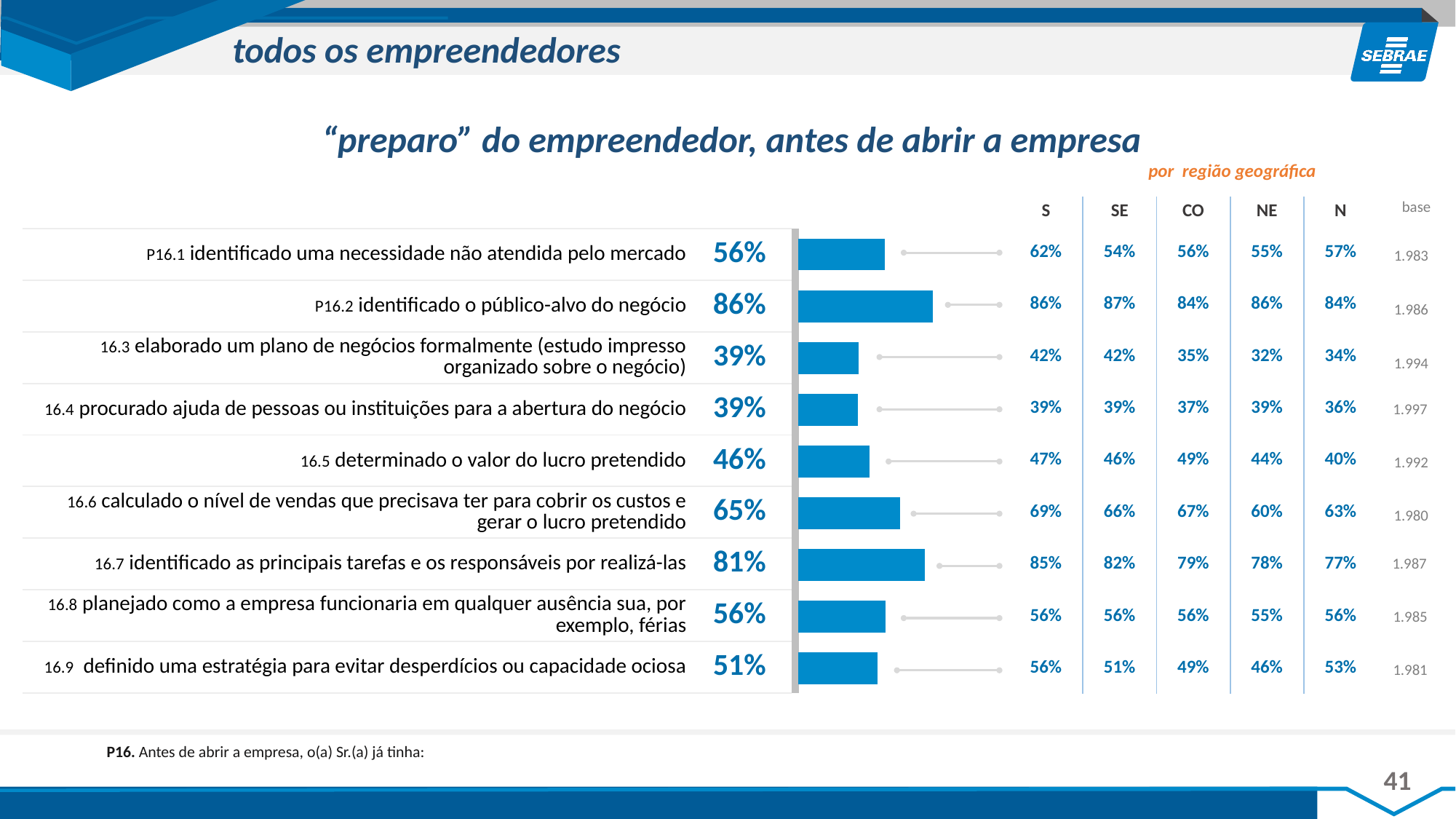
What type of chart is shown on the slide? bar chart What is the value for '16.9 definido uma estratégia para evitar desperdícios ou capacidade ociosa'? 51% Which item has the highest value in the chart? P16.2 identificado o público-alvo do negócio Which is larger: the value for '16.5 determinado o valor do lucro pretendido' or for '16.9 definido uma estratégia para evitar desperdícios ou capacidade ociosa'? 16.9 definido uma estratégia para evitar desperdícios ou capacidade ociosa In the regional table, what is the value for region S for 'P16.1 identificado uma necessidade não atendida pelo mercado'? 62% What is the value for 'P16.2 identificado o público-alvo do negócio'? 86% What is the difference between the values for '16.7 identificado as principais tarefas e os responsáveis por realizá-las' and '16.6 calculado o nível de vendas'? 16 percentage points What is the value for '16.6 calculado o nível de vendas que precisava ter para cobrir os custos e gerar o lucro pretendido'? 65% What is the title of the chart on the slide? "preparo" do empreendedor, antes de abrir a empresa How many bars (items) does the chart show? 9 What is the difference between the values for 'P16.2 identificado o público-alvo do negócio' and '16.3 elaborado um plano de negócios formalmente'? 47 percentage points What is the lowest value shown in the chart? 39%